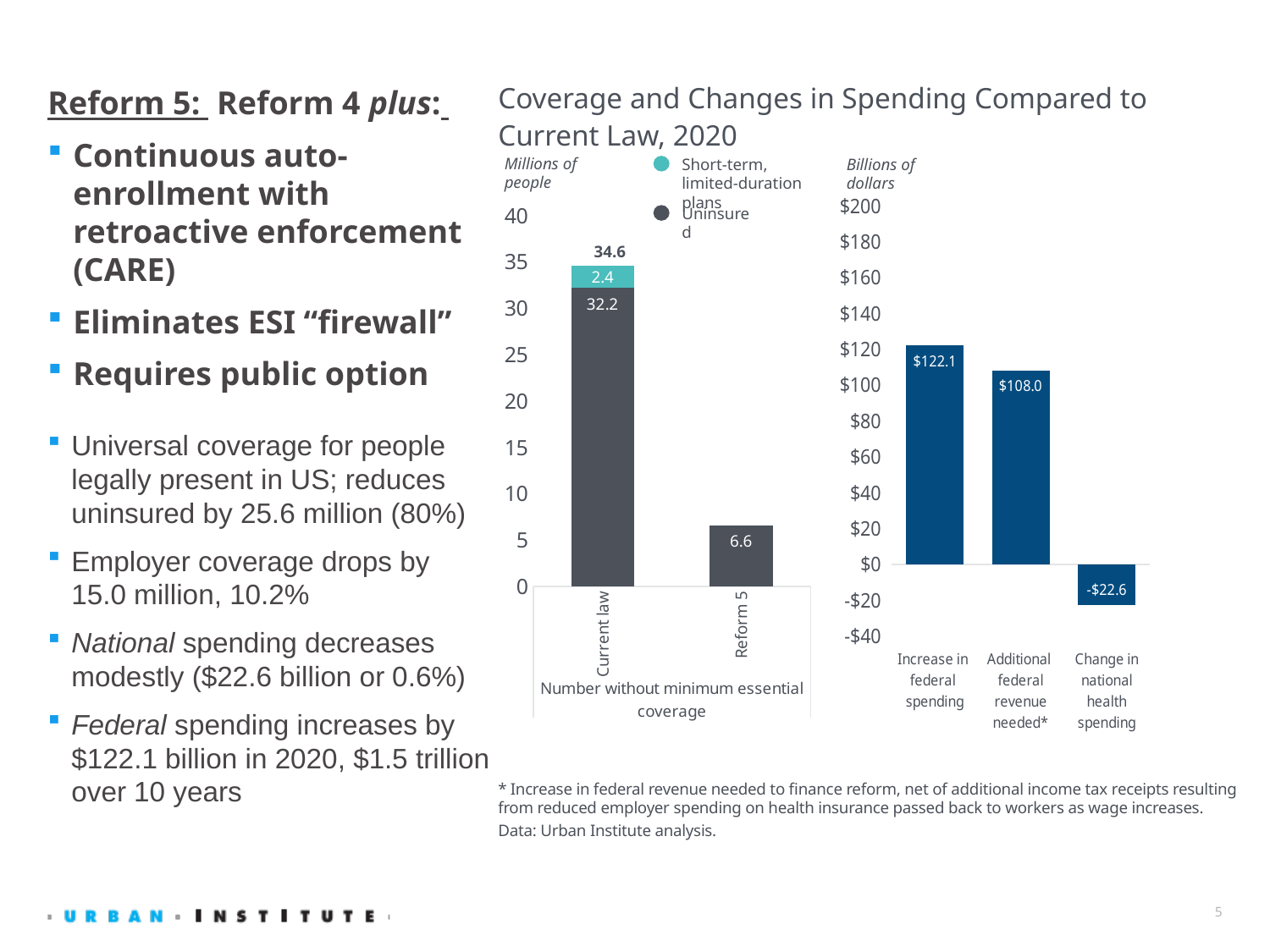
On the left chart (Number without minimum essential coverage), how many series does the legend list? 2 On the right chart (Billions of dollars), what is the value for Change in national health spending? -$22.6 On the left chart (Number without minimum essential coverage), what unit is shown on the axis label? Millions of people On the left chart (Number without minimum essential coverage), what is the difference between the Current law total and the Reform 5 value? 28.0 On the right chart (Billions of dollars), what is the value for Increase in federal spending? $122.1 On the right chart (Billions of dollars), which category has the lowest value? Change in national health spending On the right chart (Billions of dollars), what is the difference between Increase in federal spending and Additional federal revenue needed? $14.1 On the right chart (Billions of dollars), what is the value for Additional federal revenue needed? $108.0 On the left chart (Number without minimum essential coverage), what is the total for the Current law bar? 34.6 On the left chart (Number without minimum essential coverage), what is the value for Reform 5? 6.6 On the left chart (Number without minimum essential coverage), what is the Short-term, limited-duration plans value for Current law? 2.4 On the left chart (Number without minimum essential coverage), what is the Uninsured value for Current law? 32.2